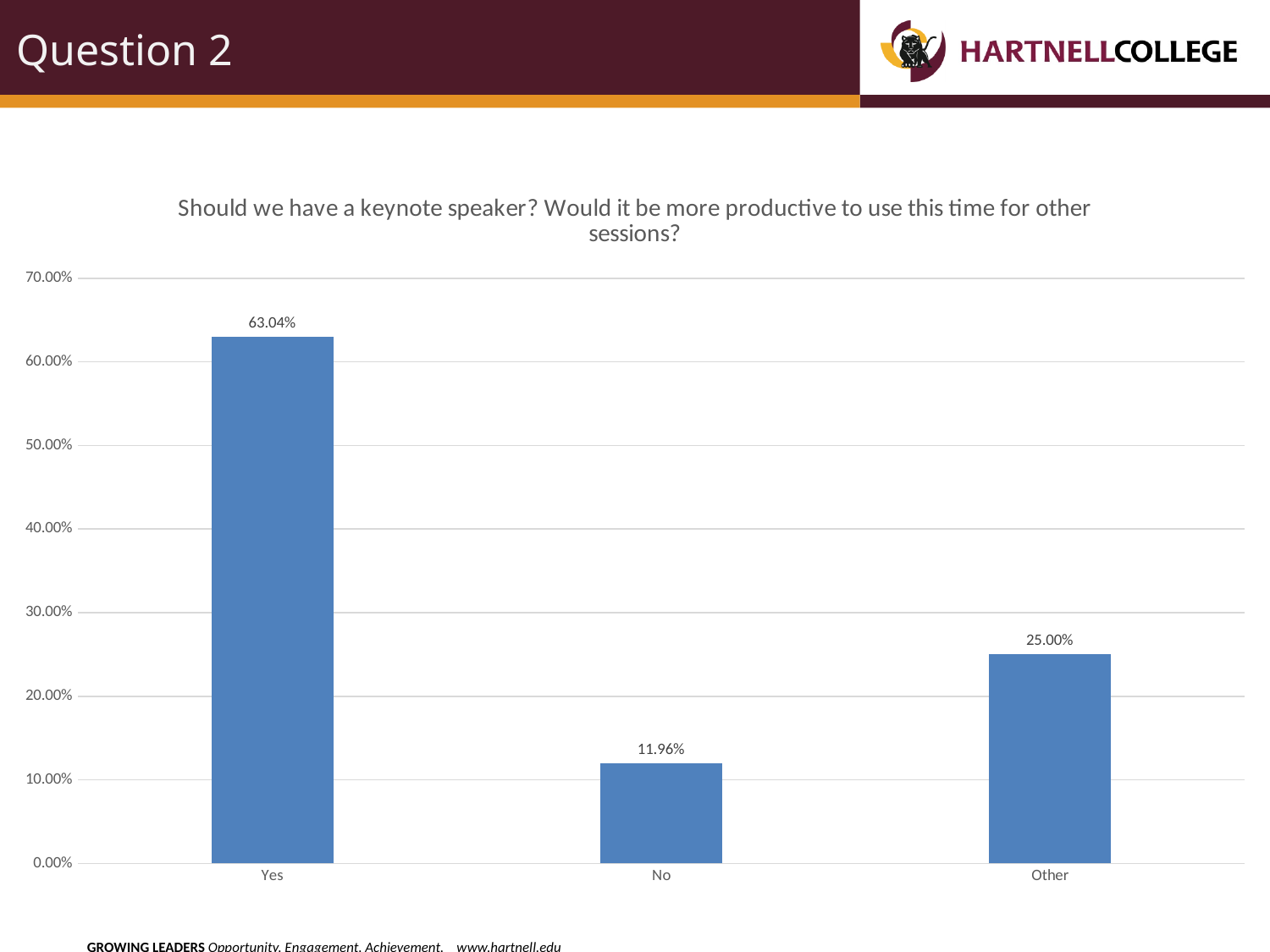
What is the value for Other? 25.00% Which category has the highest value? Yes What kind of chart is shown on the slide? bar chart What is the difference between the values for Yes and Other? 38.04% What is the title of the chart? Should we have a keynote speaker? Would it be more productive to use this time for other sessions? What is the value for No? 11.96% Which is larger, the value for No or the value for Other? Other Which category has the lowest value? No Is the value for Yes greater or less than 60.00%? greater What is the value for Yes? 63.04% How many categories are shown on the x axis? 3 What is the difference between the values for Other and No? 13.04%